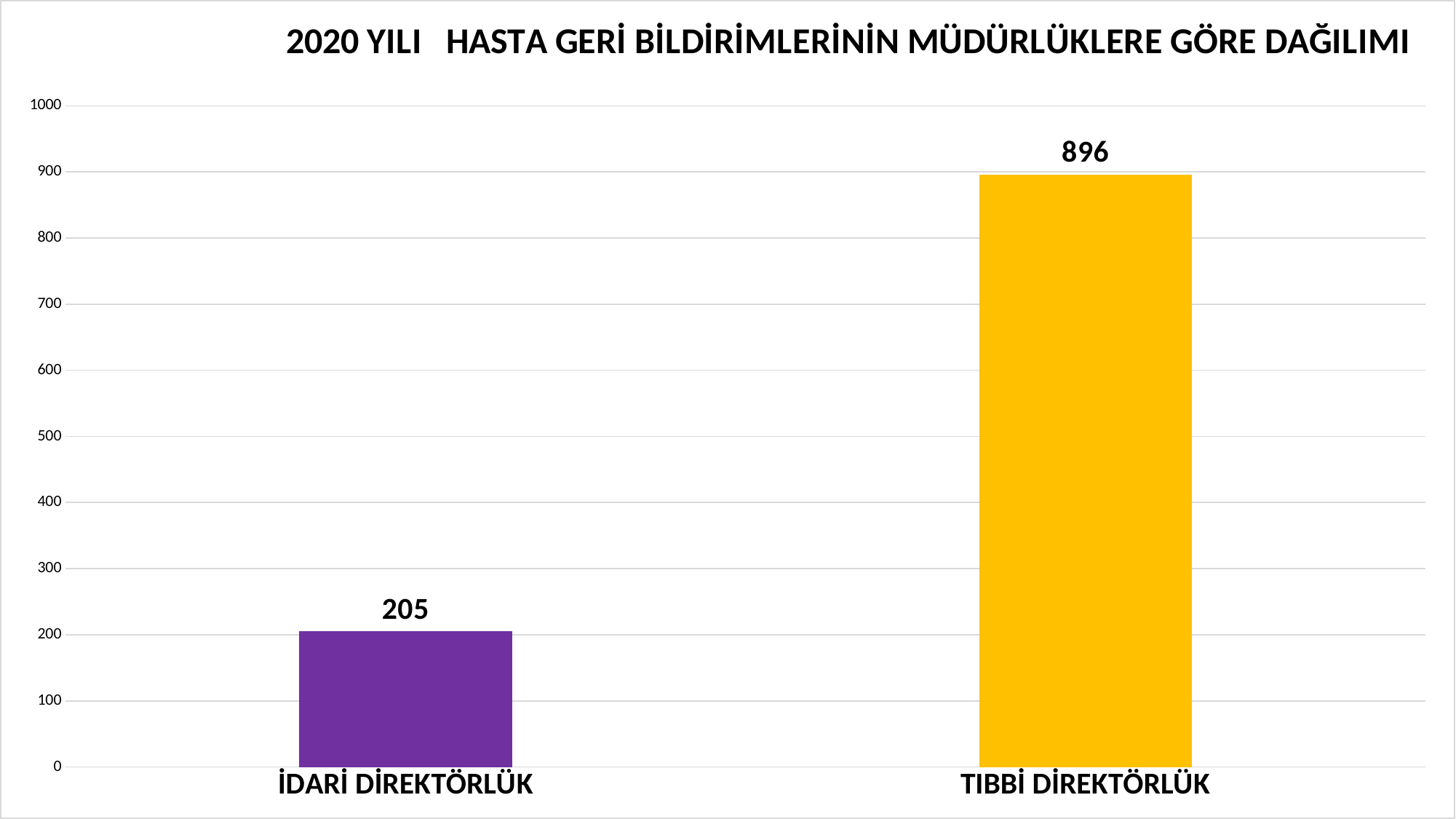
What is the value for İDARİ DİREKTÖRLÜK? 205 Which is larger, the value for İDARİ DİREKTÖRLÜK or the value for TIBBİ DİREKTÖRLÜK? TIBBİ DİREKTÖRLÜK How many categories are shown in the chart? 2 Is the value for TIBBİ DİREKTÖRLÜK greater or less than 900? less Which category has the highest value? TIBBİ DİREKTÖRLÜK What colour is the bar for TIBBİ DİREKTÖRLÜK? yellow What is the title of the chart? 2020 YILI HASTA GERİ BİLDİRİMLERİNİN MÜDÜRLÜKLERE GÖRE DAĞILIMI Which category has the lowest value? İDARİ DİREKTÖRLÜK Is the value for İDARİ DİREKTÖRLÜK greater or less than 200? greater What kind of chart is shown on the slide? bar chart What is the value for TIBBİ DİREKTÖRLÜK? 896 What is the difference between the values for TIBBİ DİREKTÖRLÜK and İDARİ DİREKTÖRLÜK? 691